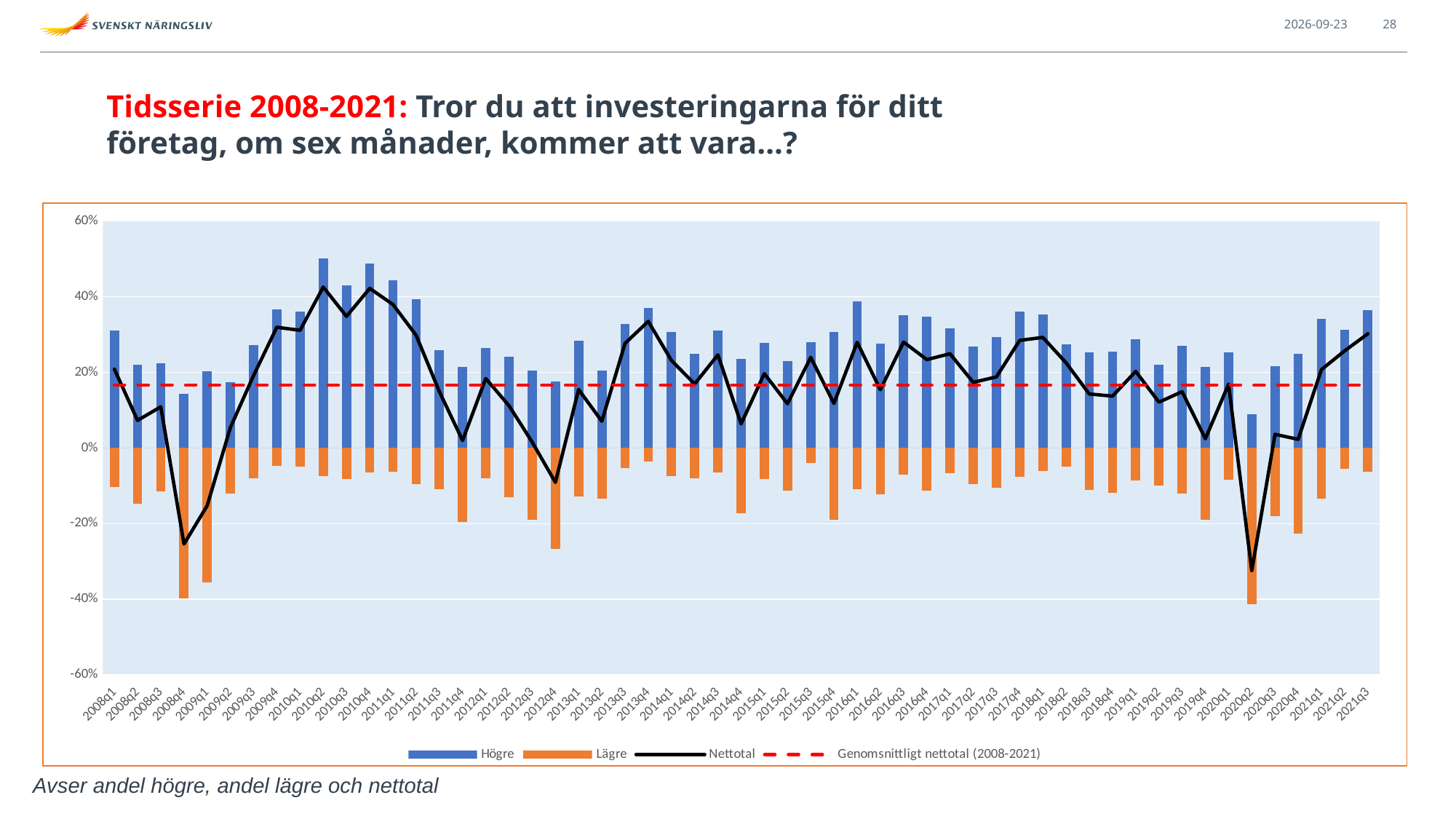
How many series does the legend list? 4 How many quarters are shown on the x axis, from 2008q1 to 2021q3? 55 Is the Nettotal value for 2012q4 greater or less than 0%? less Is the Högre value for 2010q2 greater or less than 40%? greater Is the Högre value for 2008q4 greater or less than 20%? less What does the red dashed line in the chart represent? Genomsnittligt nettotal (2008-2021) In which quarter is the Nettotal line at its lowest point? 2020q2 What kind of chart is this? Bar chart with line series Which quarter has the larger Högre value, 2010q2 or 2020q2? 2010q2 Does the Nettotal line rise or fall from 2020q2 to 2021q3? rise